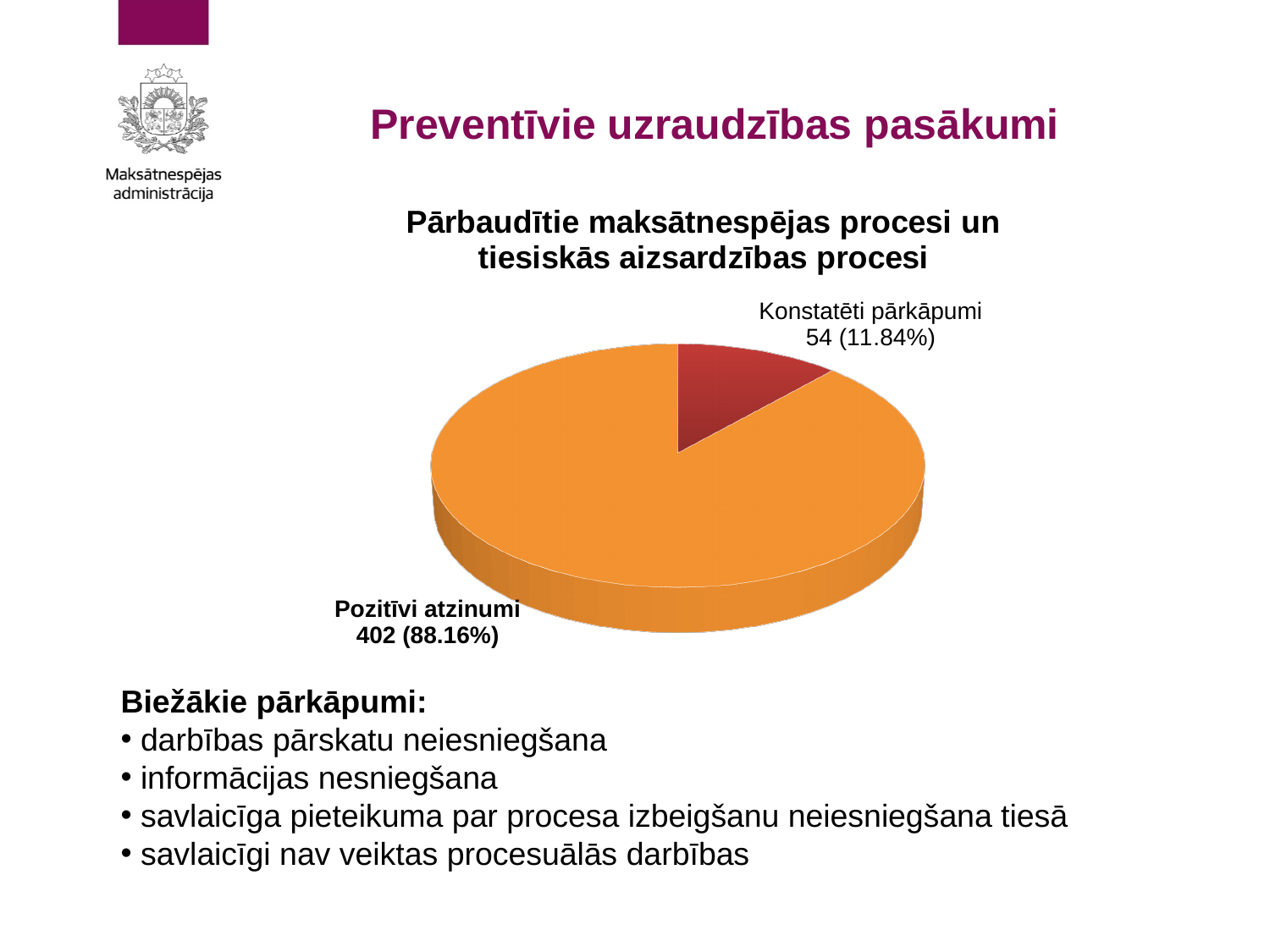
Which category has the largest slice? Pozitīvi atzinumi What is the value for Pozitīvi atzinumi? 402 What is the value for Konstatēti pārkāpumi? 54 What type of chart is shown on the slide? Pie chart What is the difference between the values for Pozitīvi atzinumi and Konstatēti pārkāpumi? 348 What share of the pie does Konstatēti pārkāpumi represent? 11.84% How many slices does the pie chart have? 2 What colour is the Konstatēti pārkāpumi slice? Red What is the title of the chart? Pārbaudītie maksātnespējas procesi un tiesiskās aizsardzības procesi What is the total of the two slices in the pie chart? 456 Which category has the smallest slice? Konstatēti pārkāpumi What share of the pie does Pozitīvi atzinumi represent? 88.16%